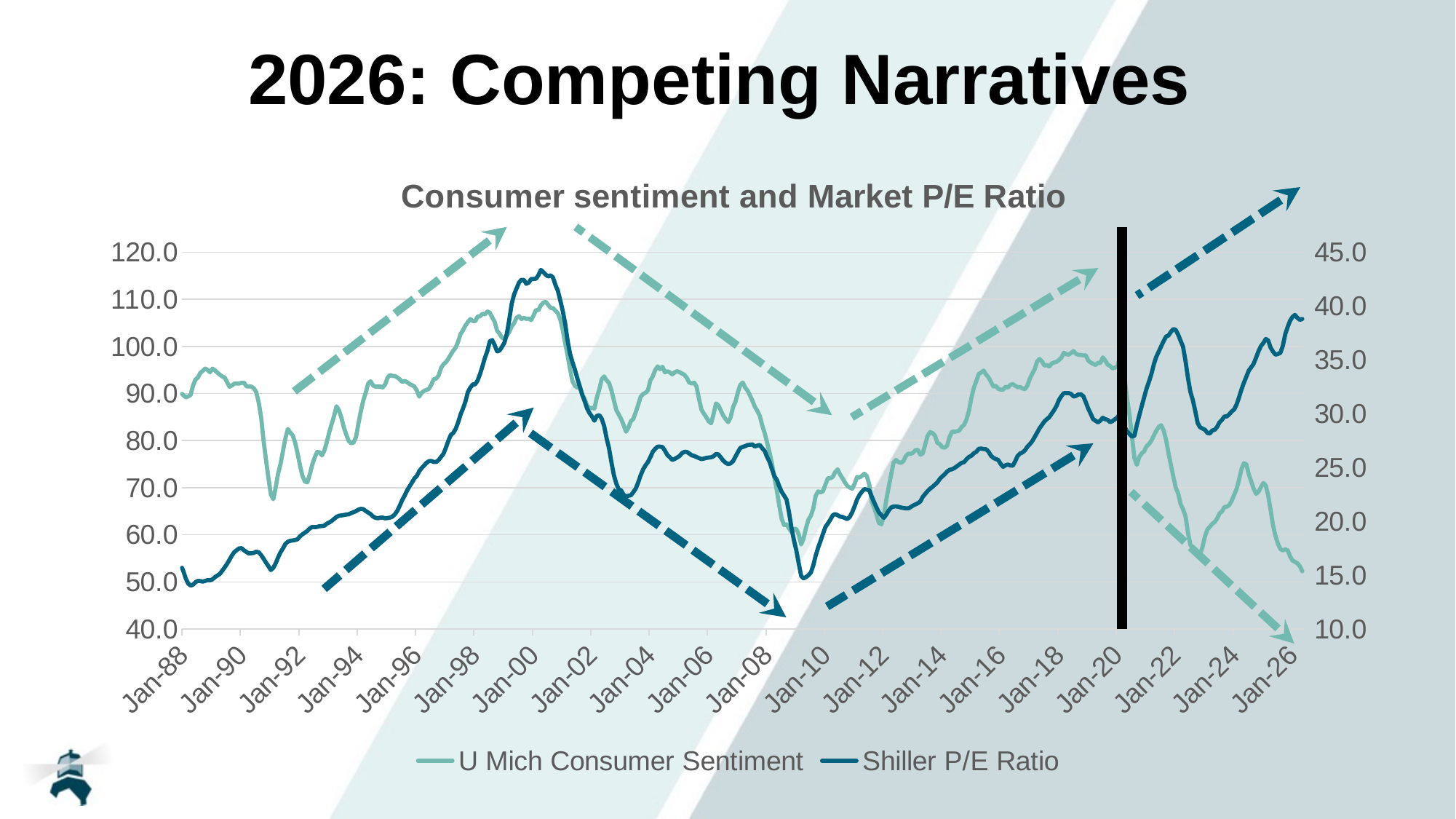
How many date labels are shown on the x axis? 20 Which two series are listed in the chart legend? U Mich Consumer Sentiment and Shiller P/E Ratio Is the peak of U Mich Consumer Sentiment around Jan-00 greater or less than 100.0 on the left axis? greater Does the U Mich Consumer Sentiment line rise or fall overall from Jan-22 to Jan-26? Fall Is the U Mich Consumer Sentiment dip around Jan-92 greater or less than 80.0 on the left axis? less What is the title of the chart? Consumer sentiment and Market P/E Ratio How many series does the chart legend list? 2 Does the Shiller P/E Ratio line rise or fall overall from Jan-22 to Jan-26? Rise Is the U Mich Consumer Sentiment value at Jan-26 greater or less than 60.0 on the left axis? less What kind of chart is shown on the slide? Line chart